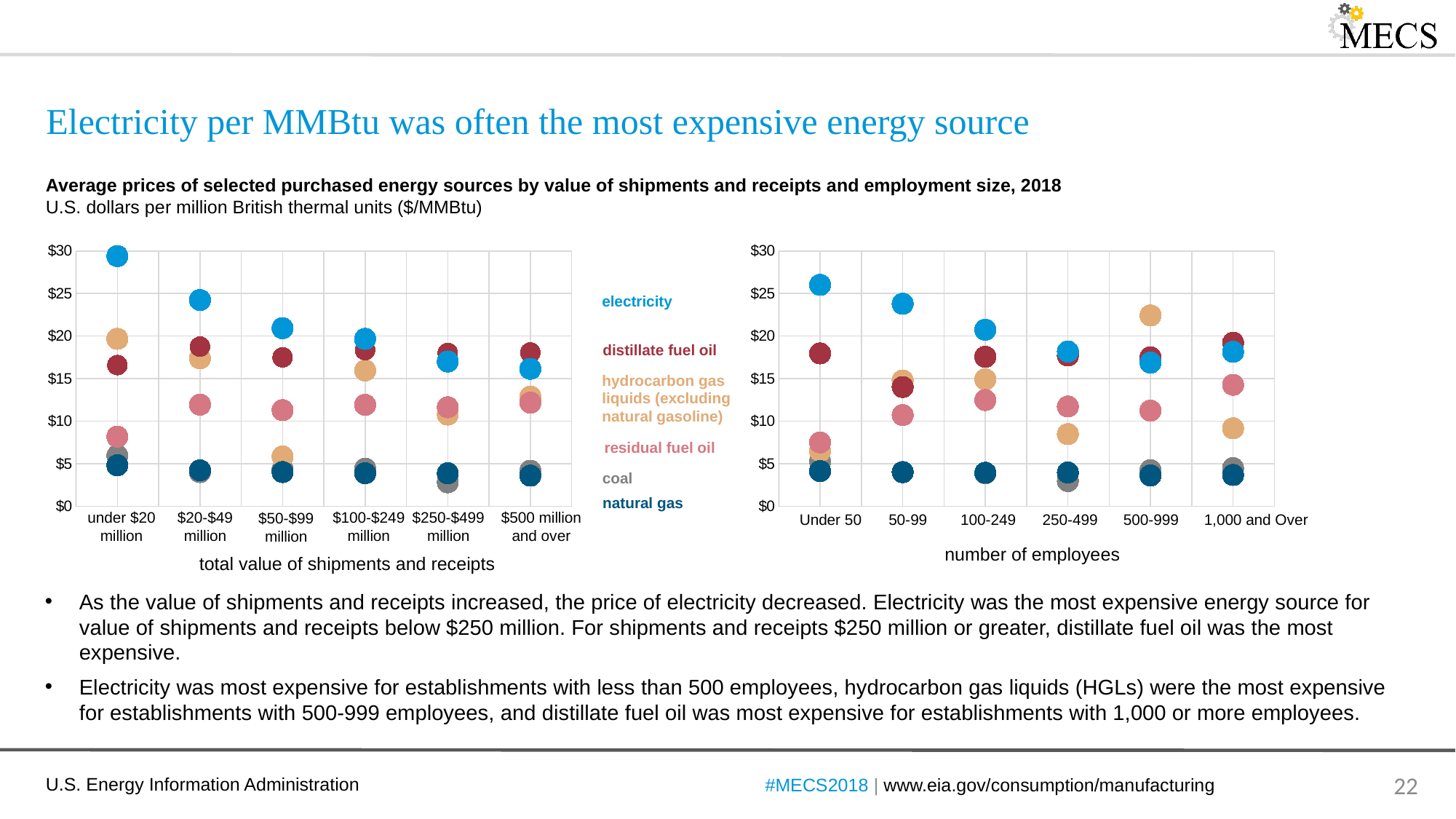
In the left chart (total value of shipments and receipts), is the residual fuel oil price for under $20 million greater or less than $10? less In the left chart (total value of shipments and receipts), which shipment-value category has the highest electricity price? under $20 million In the right chart (number of employees), which employee-size category has the highest electricity price? Under 50 How many energy sources does the legend list? 6 In the left chart (total value of shipments and receipts), is the electricity price for under $20 million greater or less than $25? greater What kind of chart is used on the left side of the slide (total value of shipments and receipts)? scatter (dot) chart In the left chart (total value of shipments and receipts), how many shipment-value categories are shown on the x axis? 6 In the right chart (number of employees), how many employee-size categories are shown on the x axis? 6 In the left chart (total value of shipments and receipts), does the electricity price rise or fall as the value of shipments and receipts increases? fall In the right chart (number of employees), is the natural gas price for 1,000 and Over employees greater or less than $5? less In the right chart (number of employees), for 500-999 employees, which is higher: the hydrocarbon gas liquids price or the electricity price? hydrocarbon gas liquids